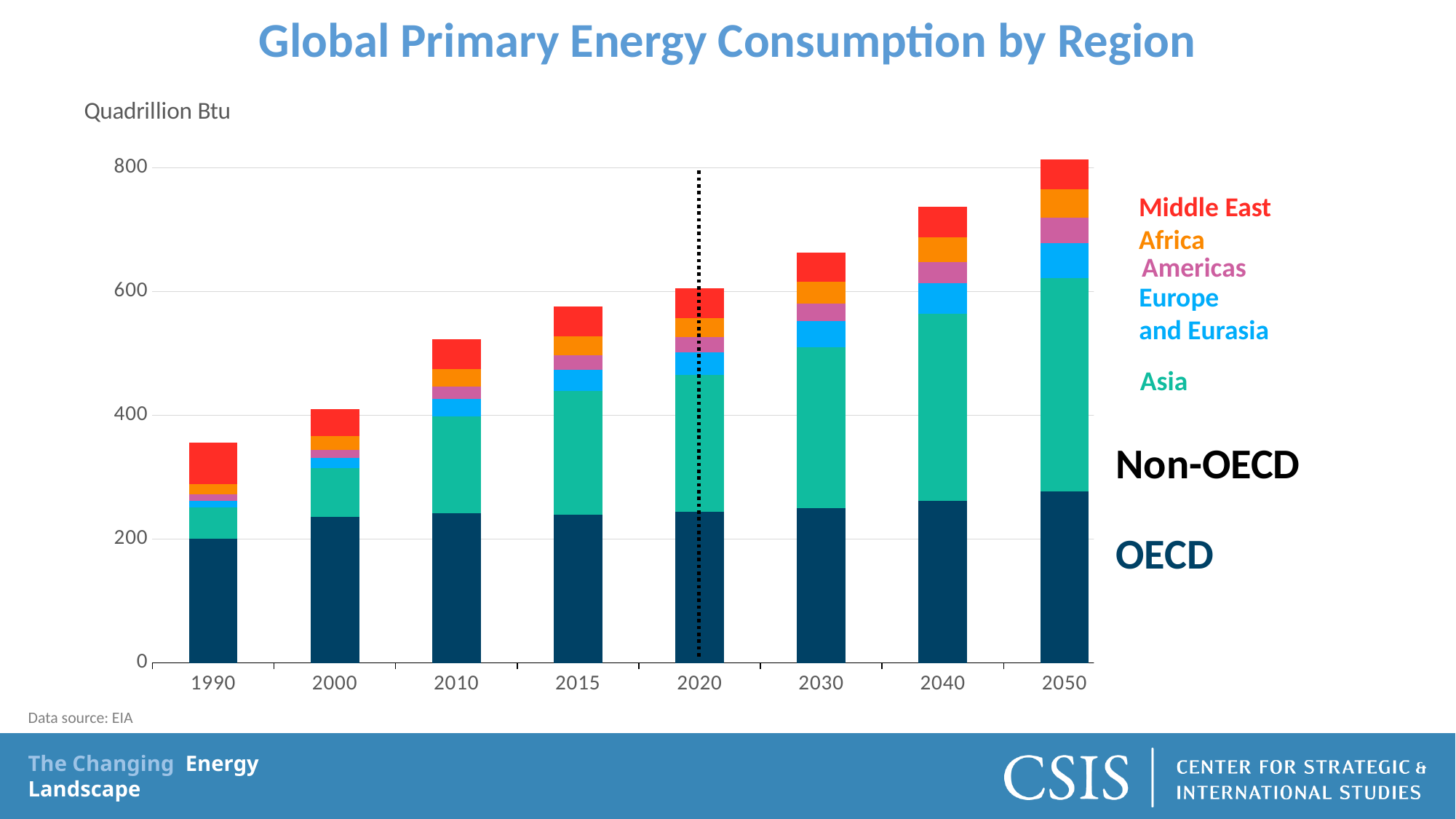
Which year has the lowest total primary energy consumption? 1990 What unit is the y axis of the chart measured in? Quadrillion Btu Is the total value for 2010 greater or less than 400? greater Is the total value for 1990 greater or less than 400? less How many regional series does the chart's legend list (including OECD)? 6 Is the total value for 2030 greater or less than 600? greater What kind of chart is shown on the slide? Stacked bar chart How many years are shown along the x axis of the chart? 8 Which is larger, the total for 2050 or the total for 1990? 2050 Which year has the highest total primary energy consumption? 2050 Do total energy consumption values rise or fall from 1990 to 2050? Rise